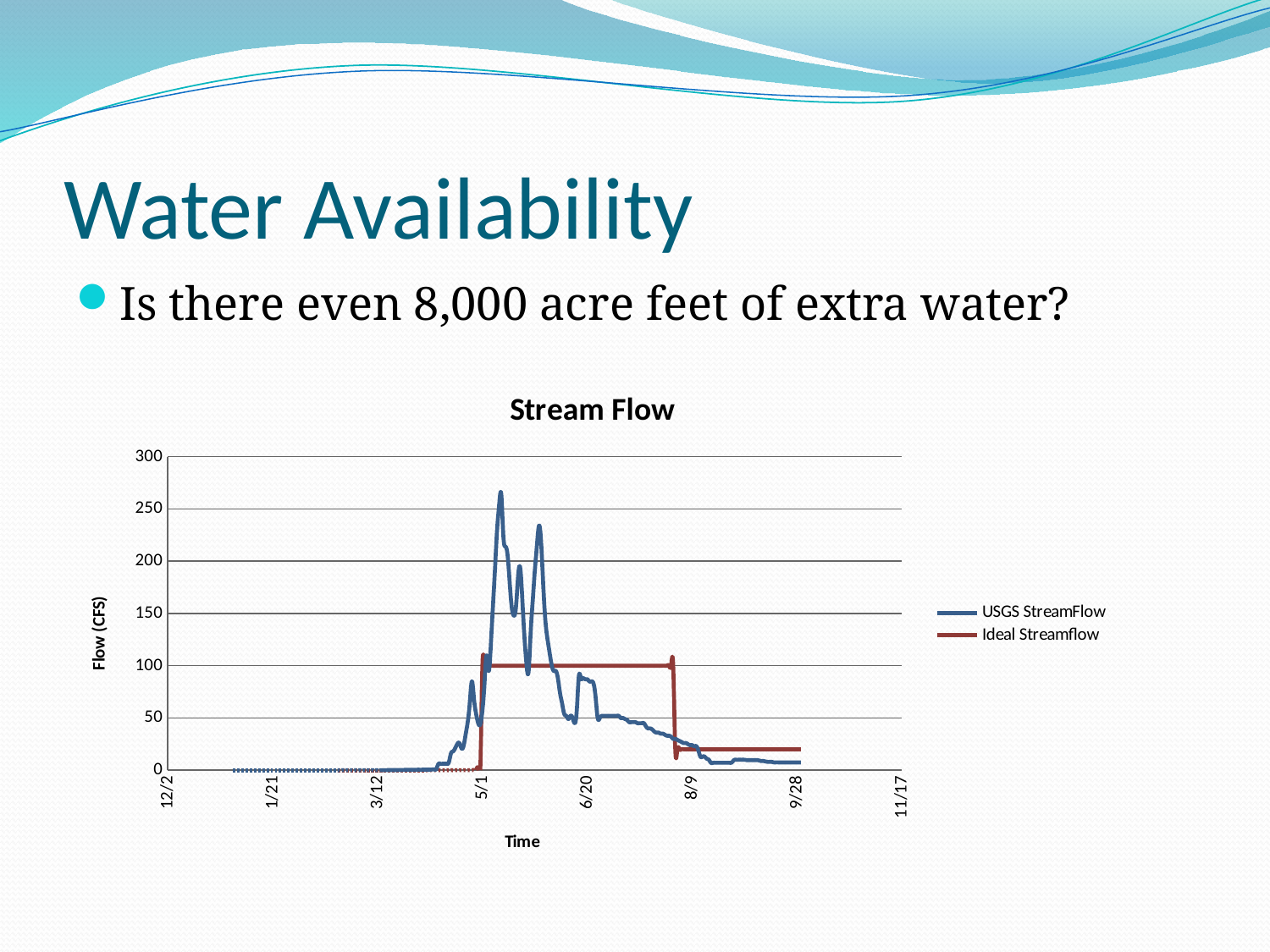
How many date tick labels are shown on the x axis of the Stream Flow chart? 8 How many series does the legend of the Stream Flow chart list? 2 What are the two series named in the legend of the Stream Flow chart? USGS StreamFlow and Ideal Streamflow What kind of chart is shown on the slide? line chart What is the label on the vertical axis of the Stream Flow chart? Flow (CFS) What flow value does the Ideal Streamflow series hold between 5/1 and early August? 100 Which series reaches the highest value on the Stream Flow chart? USGS StreamFlow Does the USGS StreamFlow series rise or fall between 6/20 and 9/28? fall At 6/20, which series has the higher value, USGS StreamFlow or Ideal Streamflow? Ideal Streamflow Is the peak value of the USGS StreamFlow series greater or less than 250? greater Is the USGS StreamFlow value at 9/28 greater or less than 50? less Is the Ideal Streamflow value between 8/9 and 9/28 greater or less than 50? less